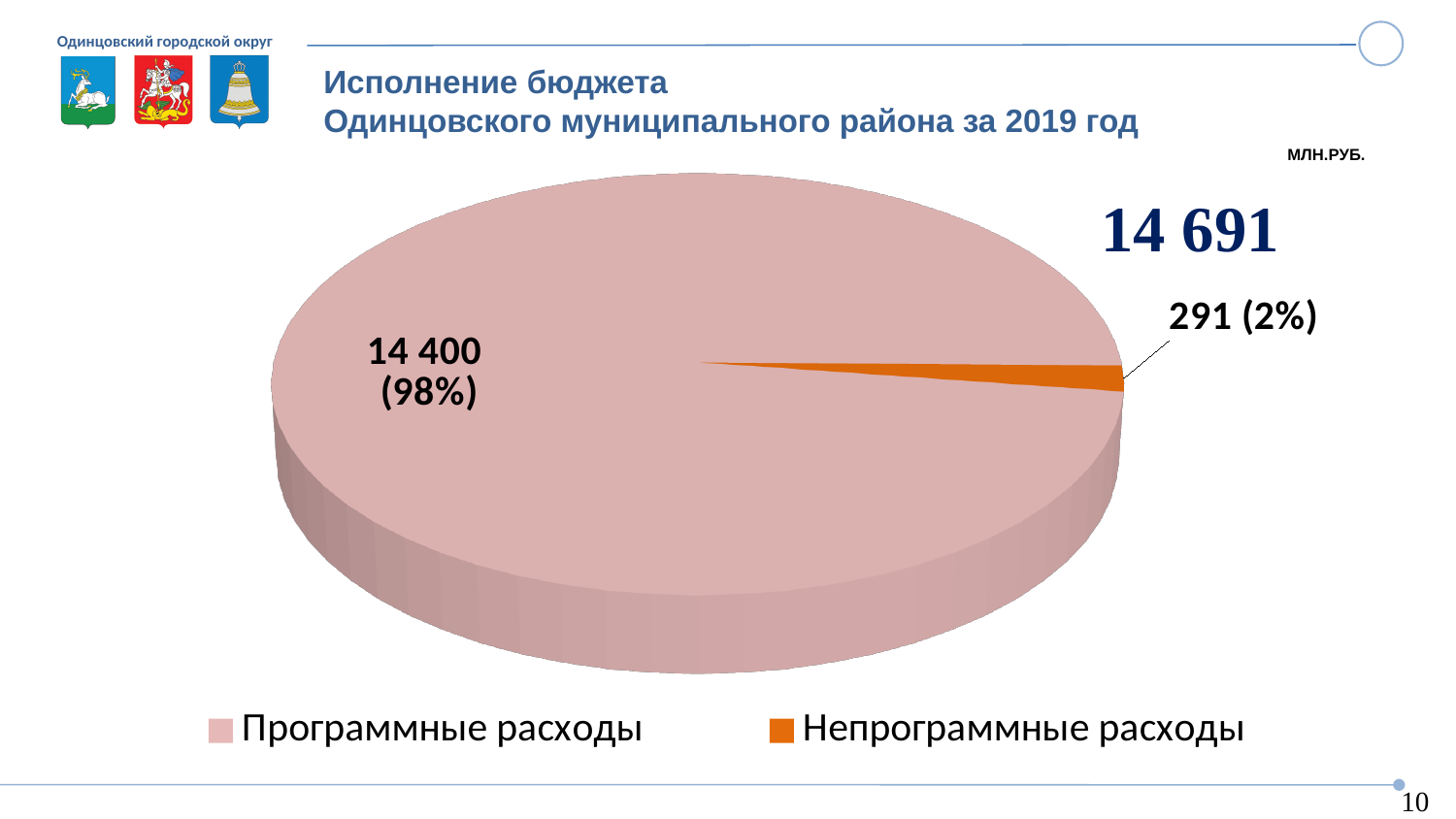
Which category has the largest slice of the pie? Программные расходы What share of the pie does Непрограммные расходы take? 2% Which category has the smallest slice of the pie? Непрограммные расходы How many slices does the pie chart have? 2 What total value is printed next to the pie chart? 14 691 Which is larger, Программные расходы or Непрограммные расходы? Программные расходы What is the value for Непрограммные расходы? 291 What is the difference between the values for Программные расходы and Непрограммные расходы? 14 109 What is the value for Программные расходы? 14 400 What unit of measurement is indicated for the chart values? МЛН.РУБ. What kind of chart is shown on the slide? pie chart What share of the pie does Программные расходы take? 98%